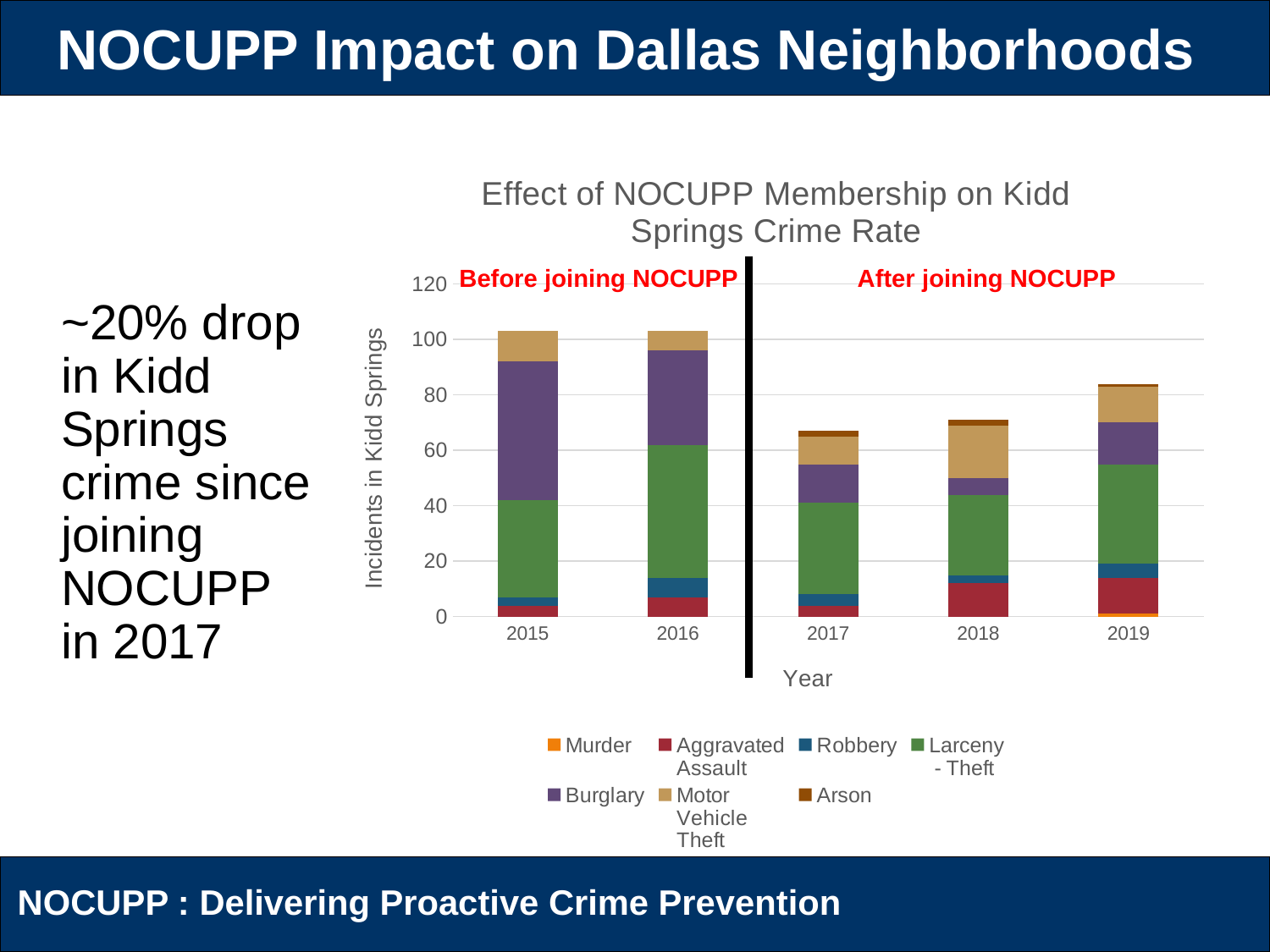
How many series does the chart's legend list? 7 Do the total incidents rise or fall from 2017 to 2019? rise How many years are shown on the x axis of the chart? 5 Which year has the larger total number of incidents, 2016 or 2017? 2016 What kind of chart is shown on the slide? Stacked bar chart Is the total number of incidents in 2018 greater or less than 80? less Is the total number of incidents in 2019 greater or less than 60? greater Is the total number of incidents in 2017 greater or less than 80? less Which year has the larger total number of incidents, 2018 or 2019? 2019 What label is shown in red above the bars to the right of the vertical black line? After joining NOCUPP What is the title of the chart? Effect of NOCUPP Membership on Kidd Springs Crime Rate